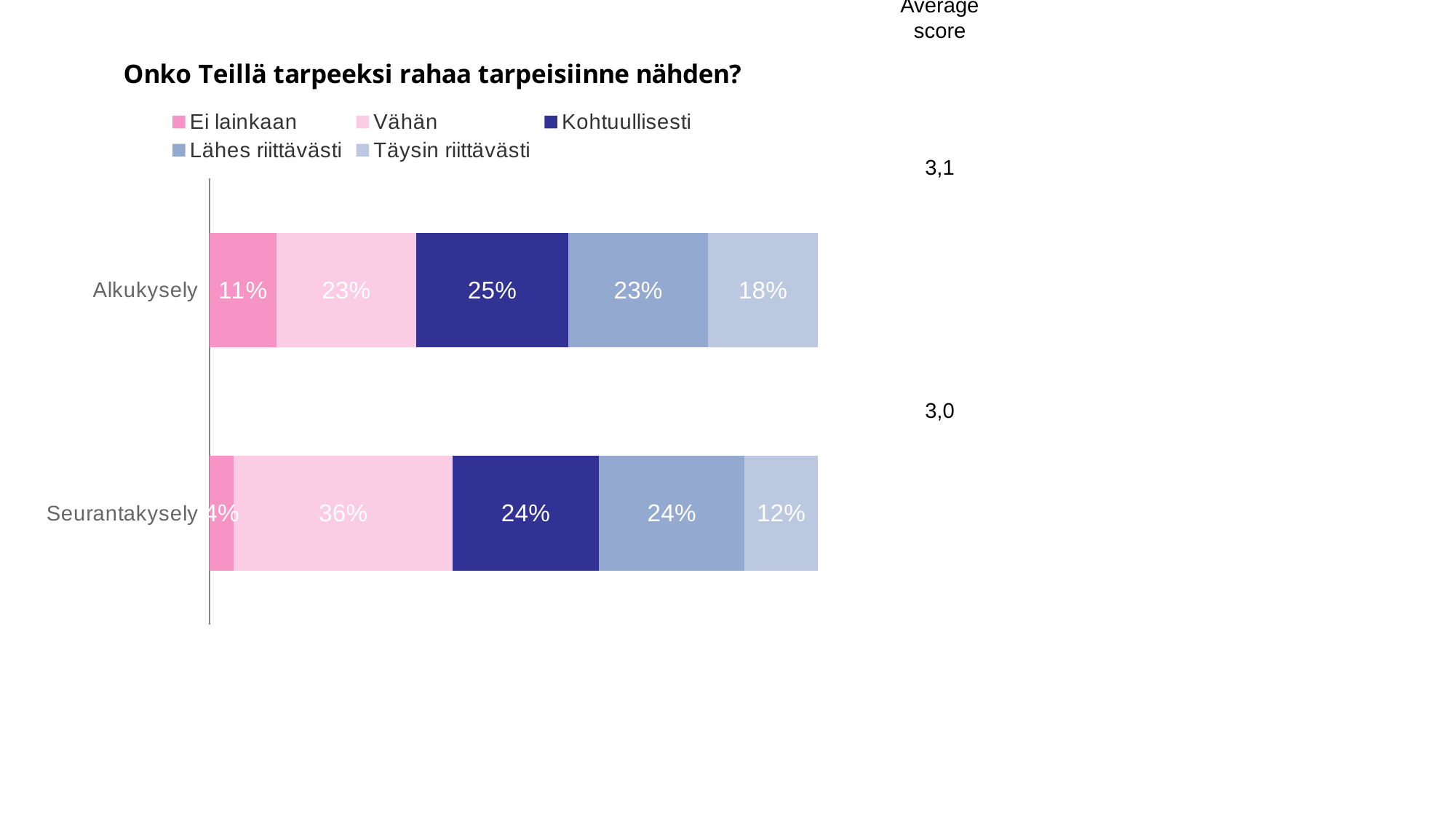
Which segment is the largest in the Seurantakysely bar? Vähän How many series does the legend list? 5 What is the difference between the Vähän values for Seurantakysely and Alkukysely? 13 percentage points What is the value for Vähän in the Seurantakysely bar? 36% Which segment is the smallest in the Seurantakysely bar? Ei lainkaan What is the value for Täysin riittävästi in the Seurantakysely bar? 12% Which is larger: Täysin riittävästi for Alkukysely or for Seurantakysely? Alkukysely How many categories are plotted on the chart? 2 What is the value for Kohtuullisesti in the Alkukysely bar? 25% What is the value for Ei lainkaan in the Alkukysely bar? 11% What is the average score shown for Alkukysely? 3,1 What kind of chart is shown on the slide? Stacked bar chart